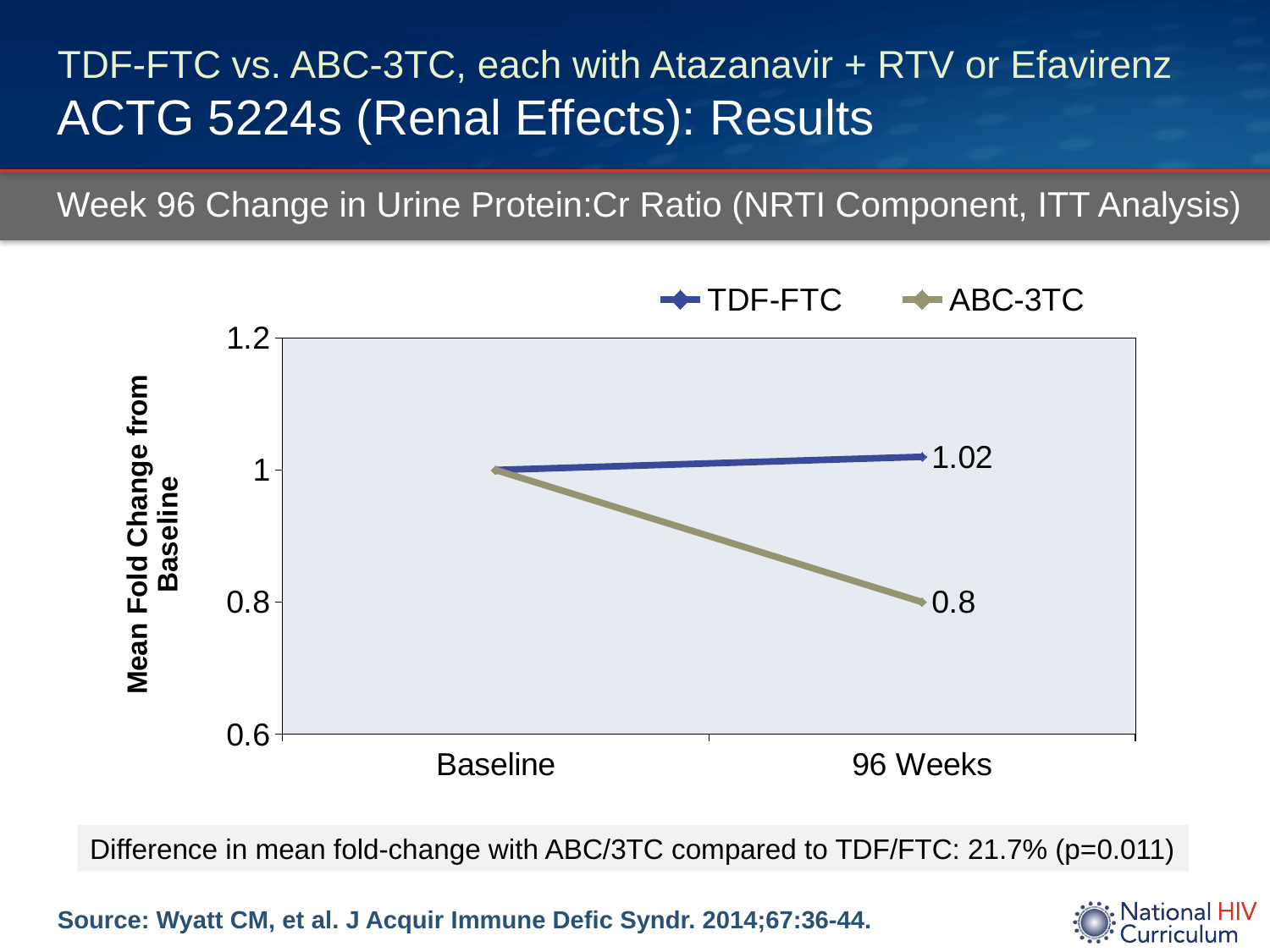
What is the mean fold change from baseline for ABC-3TC at 96 Weeks? 0.8 How many series does the legend list? 2 What kind of chart is shown on the slide? line chart Does the TDF-FTC line rise or fall from Baseline to 96 Weeks? rise Which series has the lower value at 96 Weeks? ABC-3TC What is the mean fold change from baseline for TDF-FTC at 96 Weeks? 1.02 Does the ABC-3TC line rise or fall from Baseline to 96 Weeks? fall Is the value for ABC-3TC at 96 Weeks greater or less than 1? less What is the difference between the TDF-FTC and ABC-3TC values at 96 Weeks? 0.22 What is the value for both series at Baseline? 1 How many time points are shown on the x axis? 2 Which series has the higher value at 96 Weeks? TDF-FTC